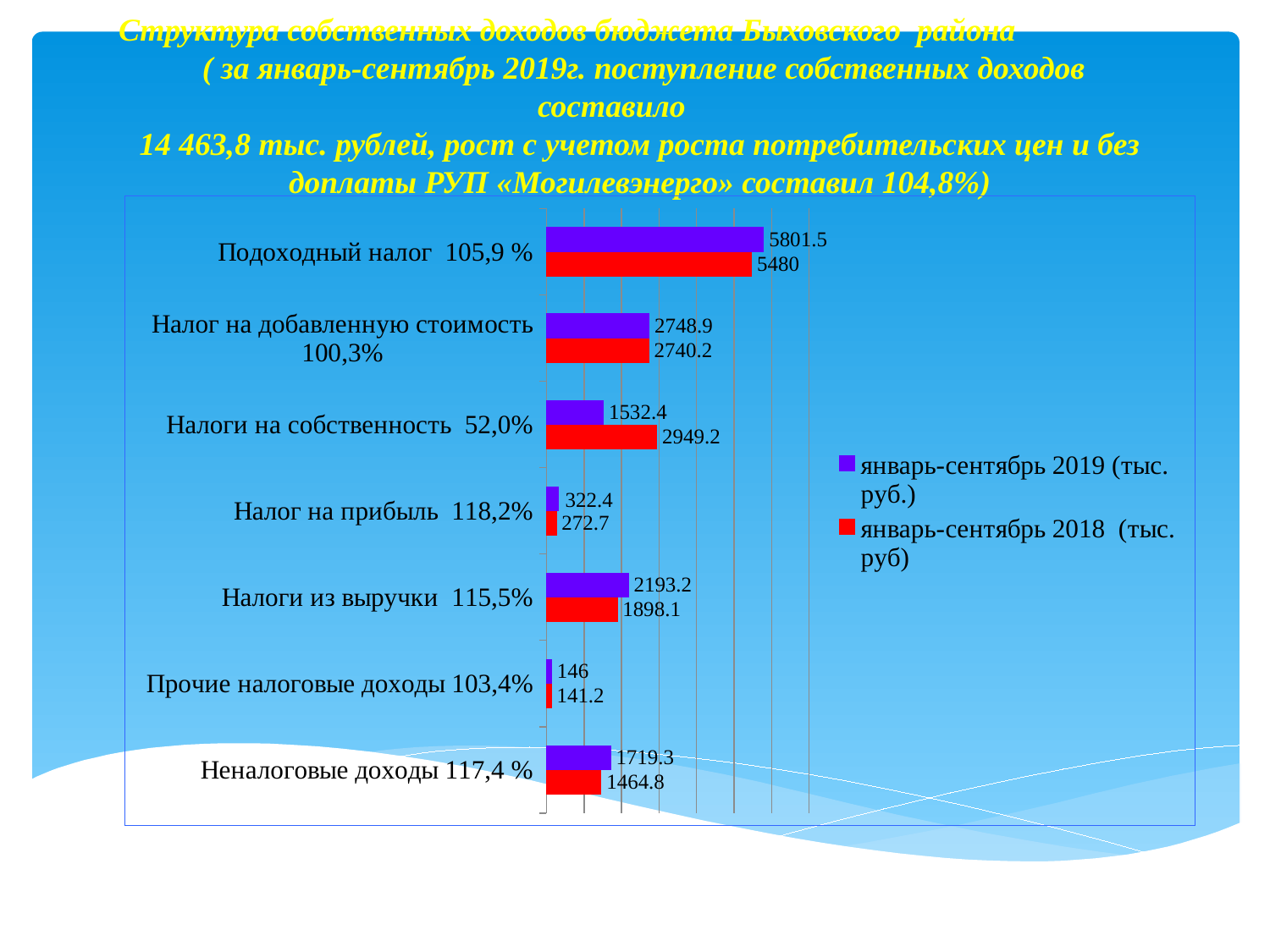
Which category has the highest value in the январь-сентябрь 2019 (тыс. руб.) series? Подоходный налог Which category has the lowest value in the январь-сентябрь 2018 (тыс. руб) series? Прочие налоговые доходы How many categories are shown on the chart? 7 How many series does the legend list? 2 What is the difference between the 2019 and 2018 values for Подоходный налог? 321.5 For Налог на прибыль, which series has the larger value: январь-сентябрь 2019 or январь-сентябрь 2018? январь-сентябрь 2019 What is the value for Прочие налоговые доходы in the январь-сентябрь 2018 (тыс. руб) series? 141.2 What is the value for Налоги из выручки in the январь-сентябрь 2019 (тыс. руб.) series? 2193.2 What is the value for Подоходный налог in the январь-сентябрь 2019 (тыс. руб.) series? 5801.5 What is the value for Налоги на собственность in the январь-сентябрь 2018 (тыс. руб) series? 2949.2 What is the difference between the 2018 and 2019 values for Налоги на собственность? 1416.8 What kind of chart is shown on the slide? Bar chart